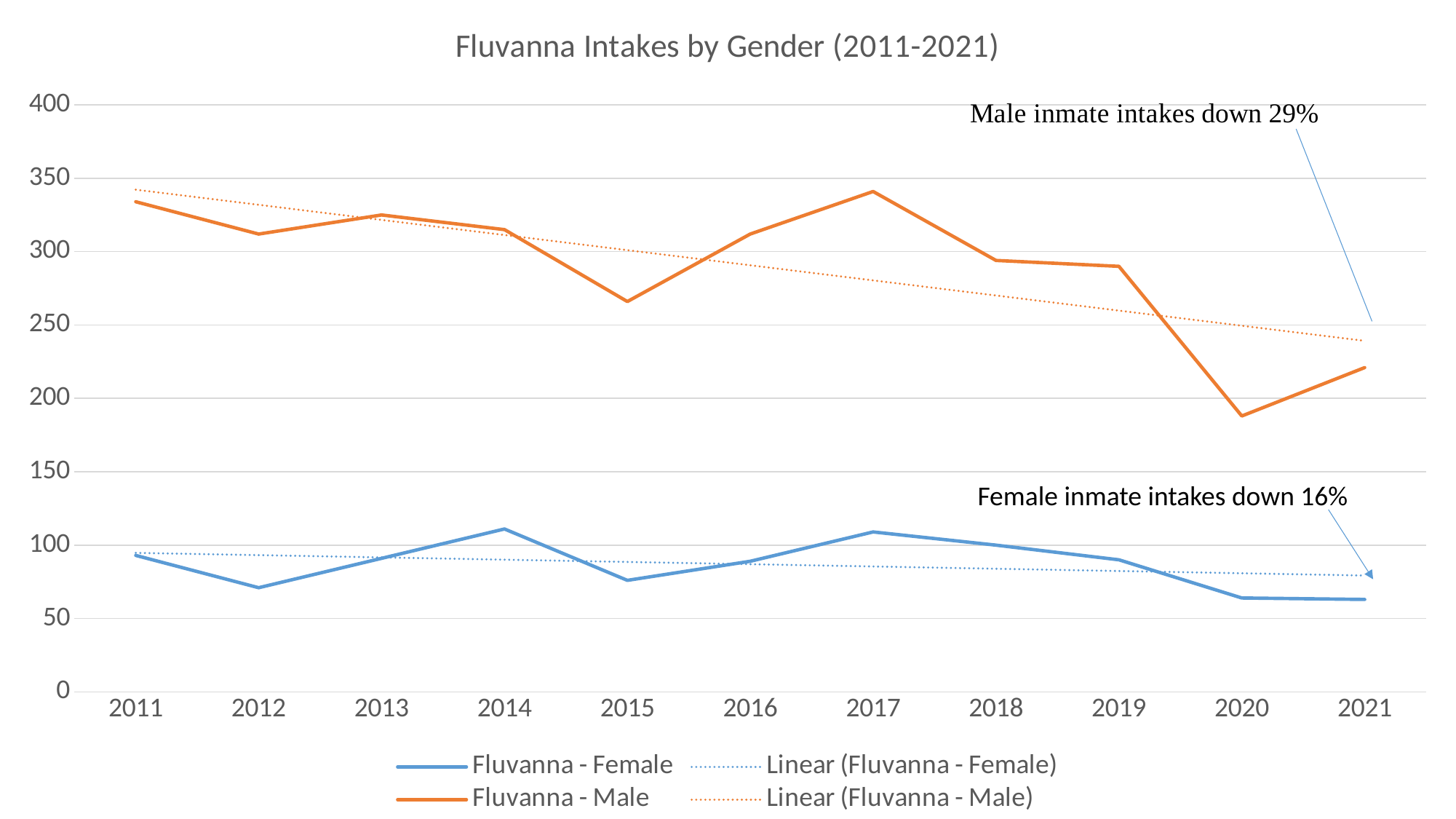
According to the annotation on the chart, by what percentage are male inmate intakes down? 29% Is the value for Fluvanna - Female in 2012 greater or less than 100? less Is the value for Fluvanna - Female in 2014 greater or less than 100? greater Which is larger for Fluvanna - Male: the value in 2015 or the value in 2016? 2016 Is the value for Fluvanna - Male in 2020 greater or less than 200? less What is the title of the chart? Fluvanna Intakes by Gender (2011-2021) How many years are shown on the x axis? 11 What kind of chart is shown on the slide? line chart How many series does the legend list? 4 Does the Fluvanna - Male series generally rise or fall from 2011 to 2021? fall In which year is the Fluvanna - Male series at its lowest? 2020